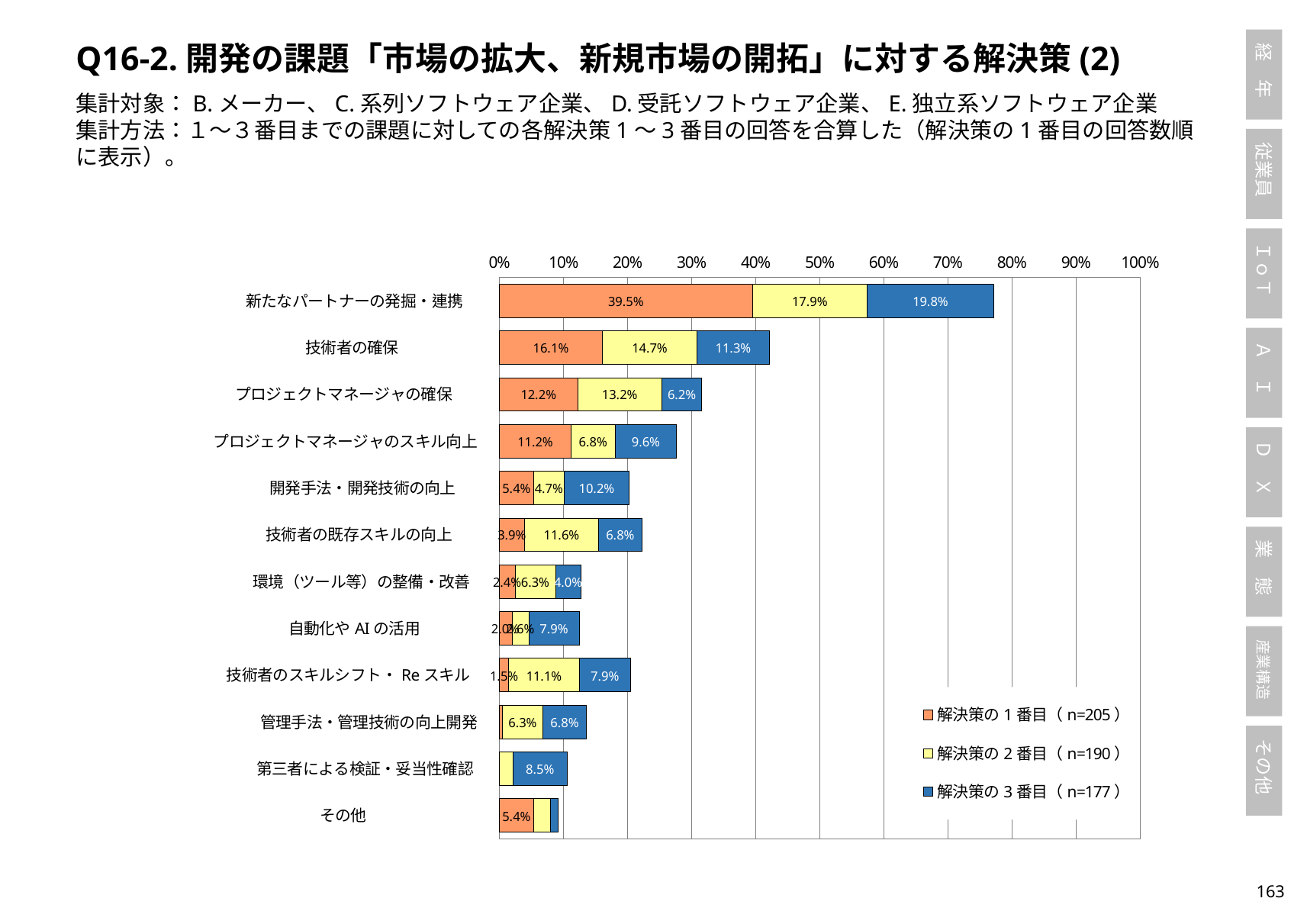
What is the n value shown in the legend for 解決策の1番目? n=205 How many series does the legend list? 3 What is the total of the stacked bar for 新たなパートナーの発掘・連携? 77.2% What is the value of 解決策の3番目 for 第三者による検証・妥当性確認? 8.5% What is the value of 解決策の3番目 for 技術者の確保? 11.3% Which category has the highest value for 解決策の1番目? 新たなパートナーの発掘・連携 What is the value of 解決策の1番目 for 新たなパートナーの発掘・連携? 39.5% What type of chart is shown on the slide? Stacked horizontal bar chart Which is larger for プロジェクトマネージャのスキル向上: 解決策の2番目 or 解決策の3番目? 解決策の3番目 How many categories are plotted on the chart? 12 What is the difference between the 解決策の1番目 values for 新たなパートナーの発掘・連携 and 技術者の確保? 23.4 percentage points What is the value of 解決策の2番目 for 技術者の既存スキルの向上? 11.6%